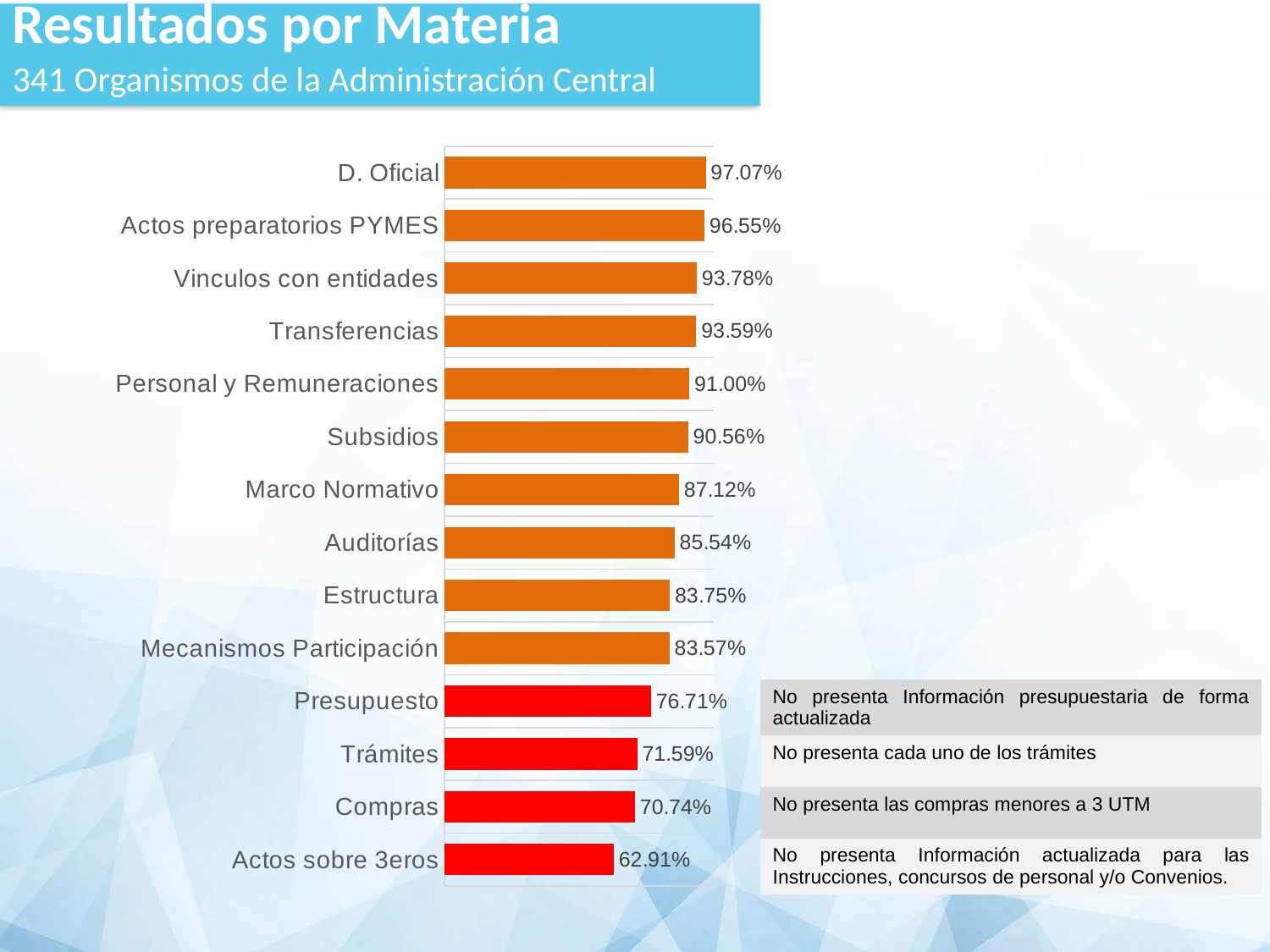
Which is larger, the value for Marco Normativo or the value for Auditorías? Marco Normativo Which category has the highest value? D. Oficial Which category has the lowest value? Actos sobre 3eros How many categories are shown in the chart? 14 What is the value for D. Oficial? 97.07% What is the difference between the values for Presupuesto and Trámites? 5.12% What is the value for Mecanismos Participación? 83.57% What is the difference between the values for D. Oficial and Actos sobre 3eros? 34.16% How many bars are coloured red? 4 What is the value for Subsidios? 90.56% What is the value for Compras? 70.74% What kind of chart is shown on the slide? Bar chart